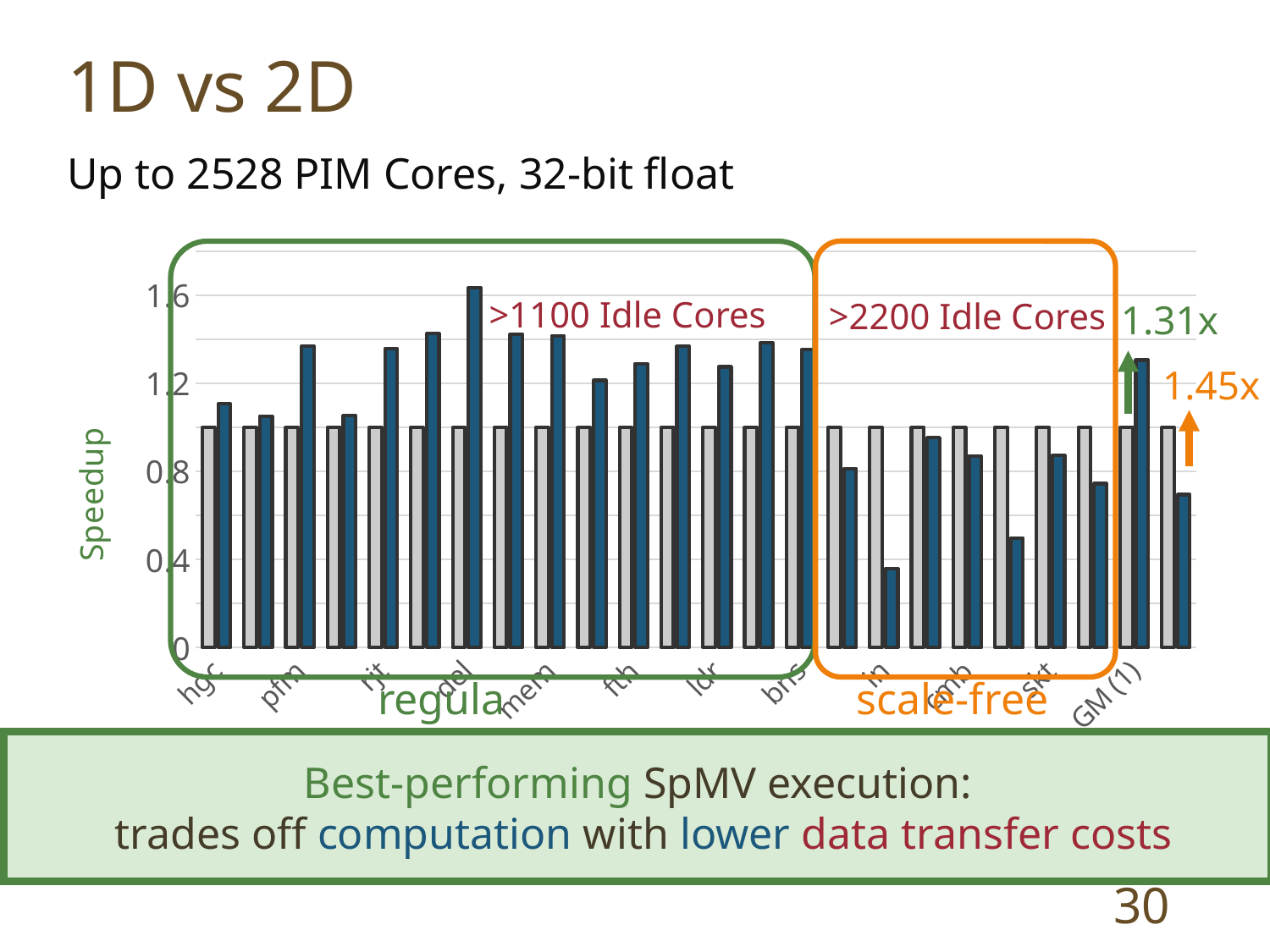
What speedup value is annotated next to the green arrow at the right of the chart? 1.31x Which is larger, the blue bar for del or the blue bar for hgc? del Is the blue bar for skt greater or less than 1.2? less Which category has the highest blue bar in the chart? del What kind of chart is shown on the slide? bar chart What speedup value is annotated next to the orange arrow at the right of the chart? 1.45x Is the lowest blue bar in the chart in the regular group or the scale-free group? scale-free Is the blue bar for pfm greater or less than 1.2? greater What annotation about idle cores is written inside the green box over the regular group? >1100 Idle Cores Is the blue bar for rjt greater or less than 1.2? greater What is the label of the y axis of the chart? Speedup